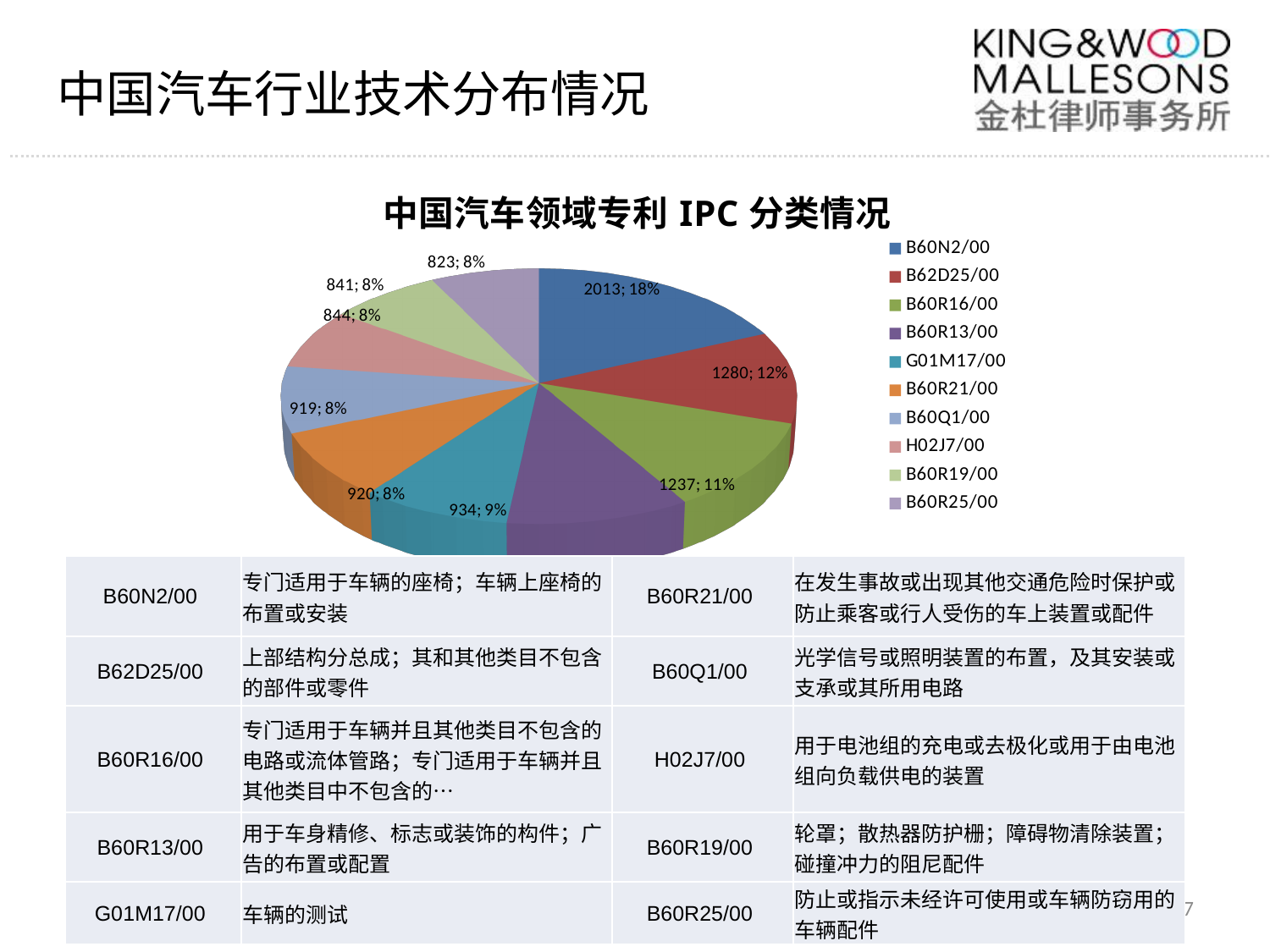
What share of the pie does B60N2/00 represent? 18% Which IPC category has the largest slice? B60N2/00 What share of the pie does B60R16/00 represent? 11% What is the difference between the values for B60N2/00 and B62D25/00? 733 How many slices does the pie chart have? 10 What is the title of the chart? 中国汽车领域专利 IPC 分类情况 Which is larger, the value for B62D25/00 or the value for G01M17/00? B62D25/00 How many IPC categories does the legend list? 10 What kind of chart is shown on the slide? pie chart What value is shown for B60N2/00? 2013 What value is shown for G01M17/00? 934 What value is shown for B62D25/00? 1280